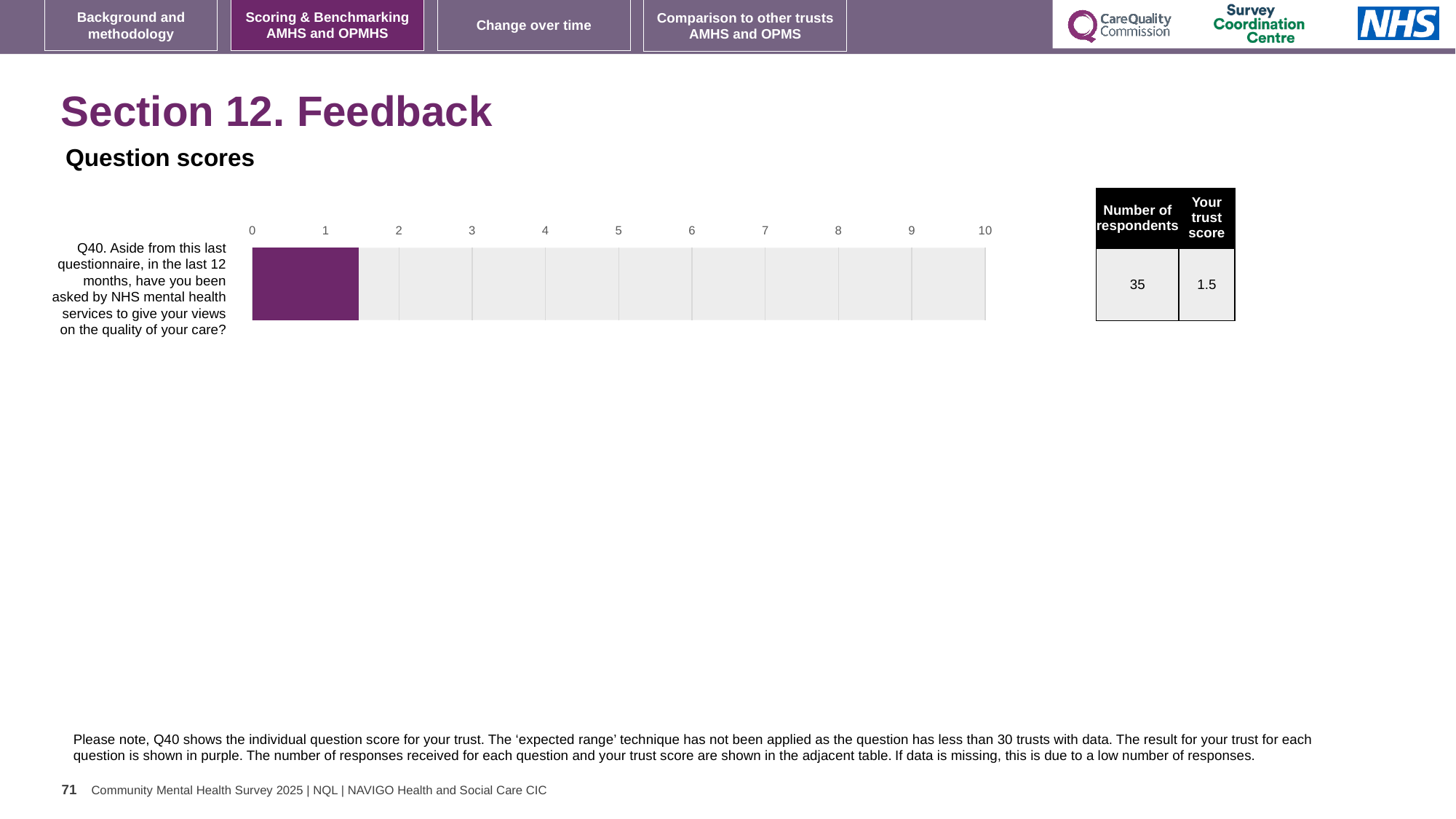
What is the trust score for Q40 shown in the table next to the chart? 1.5 How many questions (categories) are plotted in the chart? 1 Is the value of the bar for Q40 greater or less than 2? less How many respondents answered Q40 according to the table beside the chart? 35 Is the value of the bar for Q40 greater or less than 1? greater What is the maximum value shown on the chart's axis? 10 Which question number is plotted in the chart? Q40 Is the value of the bar for Q40 greater or less than 5? less What kind of chart is shown on the slide? Bar chart What colour is the bar showing the trust's result for Q40? Purple